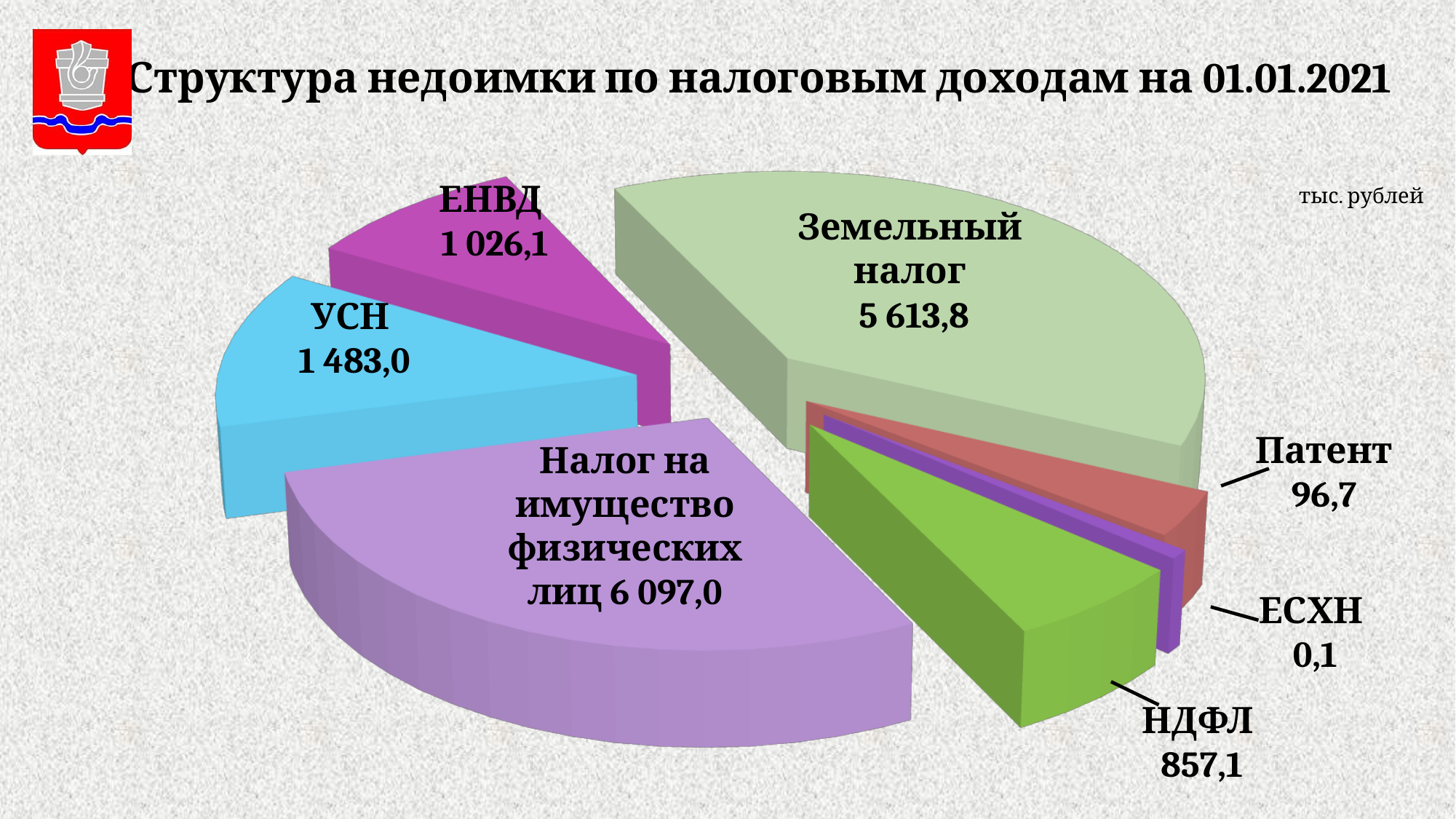
Which is larger, ЕНВД or НДФЛ? ЕНВД What is the value for Патент? 96,7 What is the difference between УСН and ЕНВД? 456,9 Which category has the smallest value? ЕСХН What is the value for НДФЛ? 857,1 What is the value for УСН? 1 483,0 What is the value for Земельный налог? 5 613,8 What is the difference between Налог на имущество физических лиц and Земельный налог? 483,2 How many slices does the pie chart have? 7 What kind of chart is shown on the slide? Pie chart What is the title of the chart? Структура недоимки по налоговым доходам на 01.01.2021 Which category has the largest value? Налог на имущество физических лиц